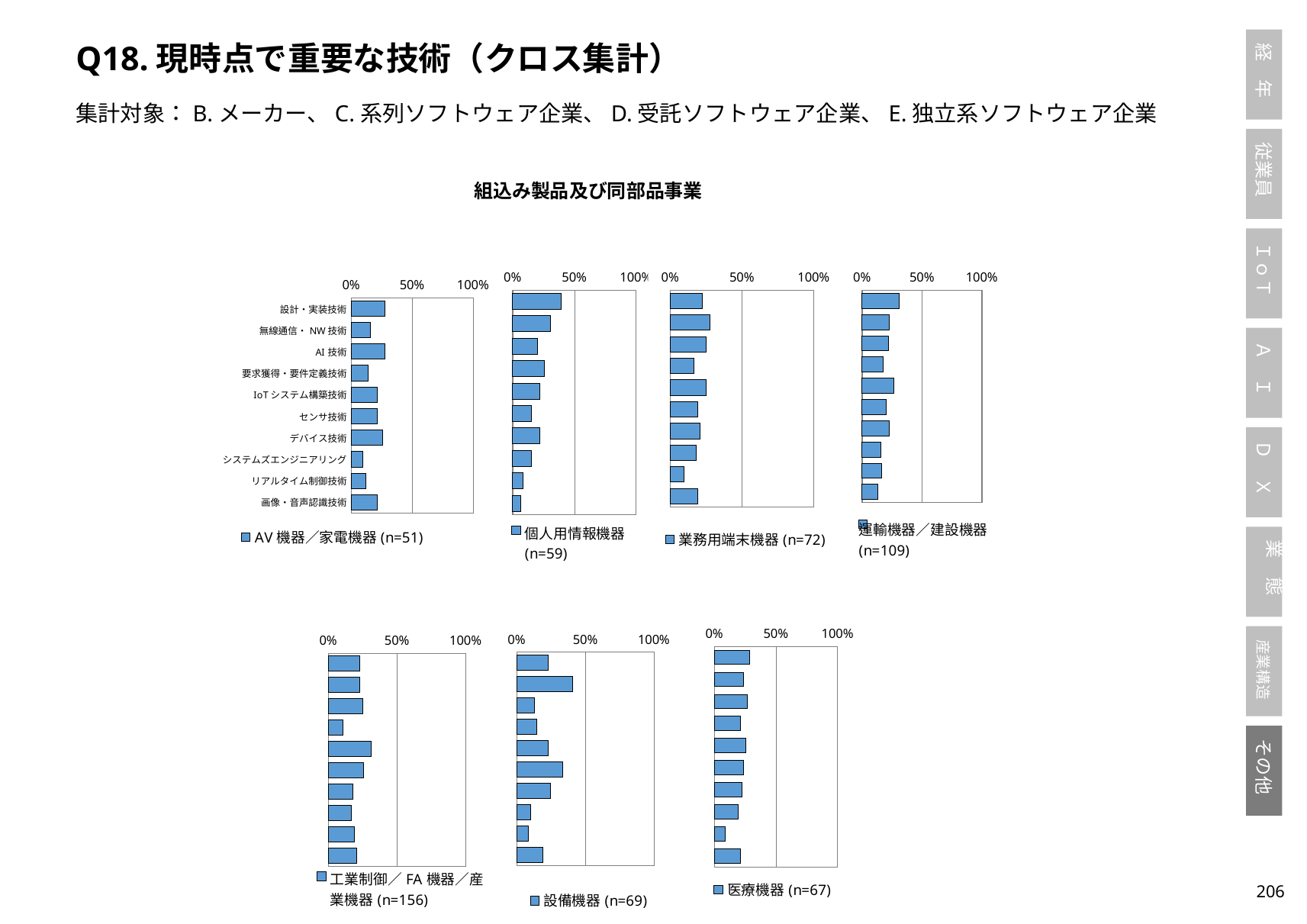
In the 個人用情報機器 (n=59) chart, is the value for 設計・実装技術 greater or less than 50%? less How many technology categories are listed on the AV機器／家電機器 (n=51) chart? 10 In the 設備機器 (n=69) chart, is the value for 無線通信・NW技術 larger or smaller than the value for AI技術? larger How many series does the legend of the 業務用端末機器 chart list? 1 In the 個人用情報機器 (n=59) chart, which technology has the highest value? 設計・実装技術 In the 工業制御／FA機器／産業機器 (n=156) chart, which technology has the lowest value? 要求獲得・要件定義技術 What kind of chart is used for the AV機器／家電機器 (n=51) panel? bar chart In the 工業制御／FA機器／産業機器 (n=156) chart, which technology has the highest value? IoTシステム構築技術 In the 医療機器 (n=67) chart, which technology has the lowest value? リアルタイム制御技術 In the 設備機器 (n=69) chart, which technology has the highest value? 無線通信・NW技術 How many small bar charts are shown on the slide? 7 What is the sample size (n) shown in the legend of the 運輸機器／建設機器 chart? n=109